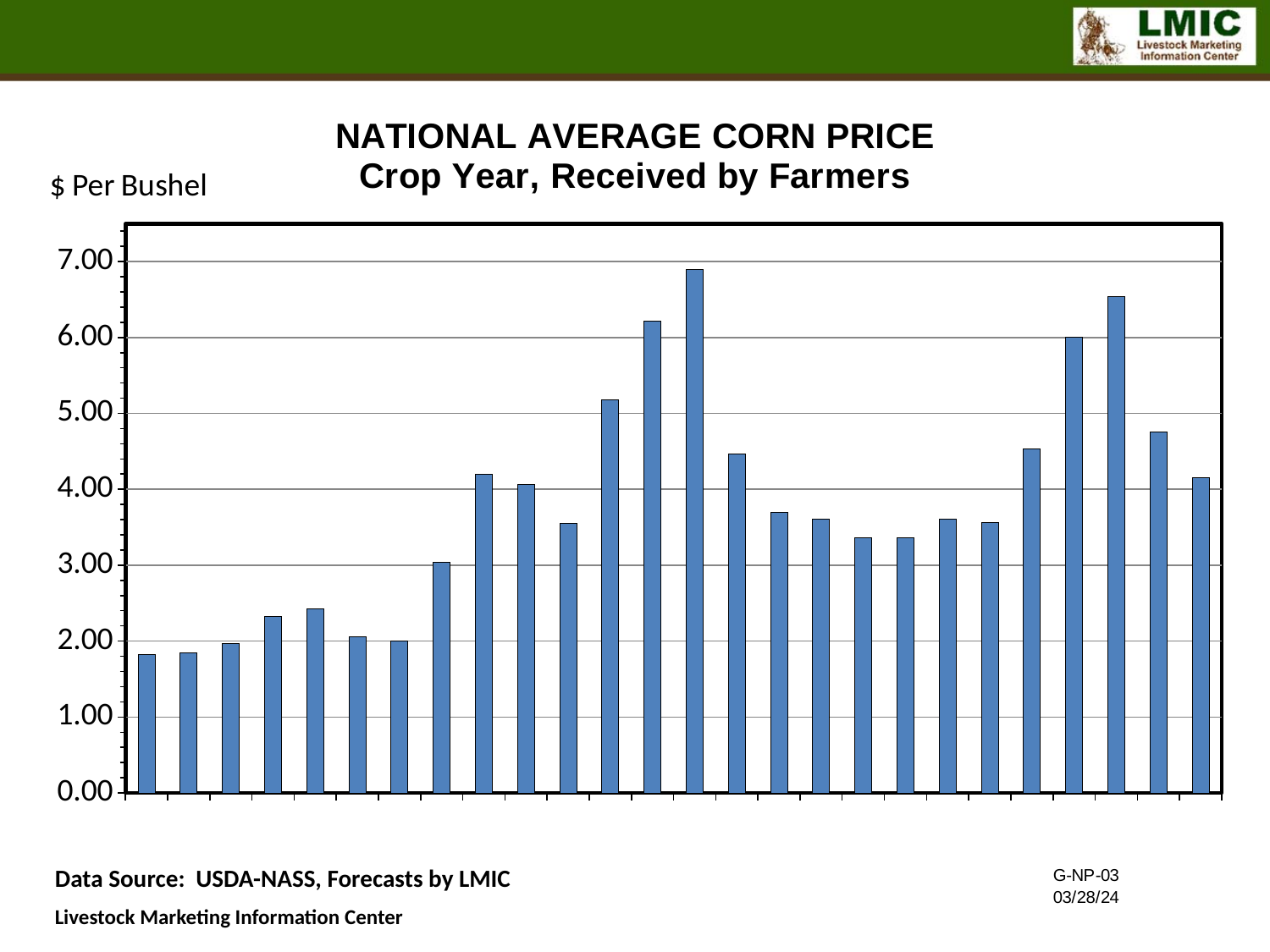
How many bars are plotted in the chart? 26 Is the value of the last (rightmost) bar greater or less than 4.00? greater Which bar, counting from the left, is the shortest? the first bar What is the title of the chart? NATIONAL AVERAGE CORN PRICE Crop Year, Received by Farmers Do the values rise or fall across the first five bars from the left? rise Which bar, counting from the left, is the tallest? the 14th bar Is the value of the 5th bar from the left greater or less than 3.00? less Is the value of the first (leftmost) bar greater or less than 2.00? less What unit label is shown above the vertical axis? $ Per Bushel Which is larger, the first bar or the last bar? the last bar What kind of chart is shown on the slide? bar chart